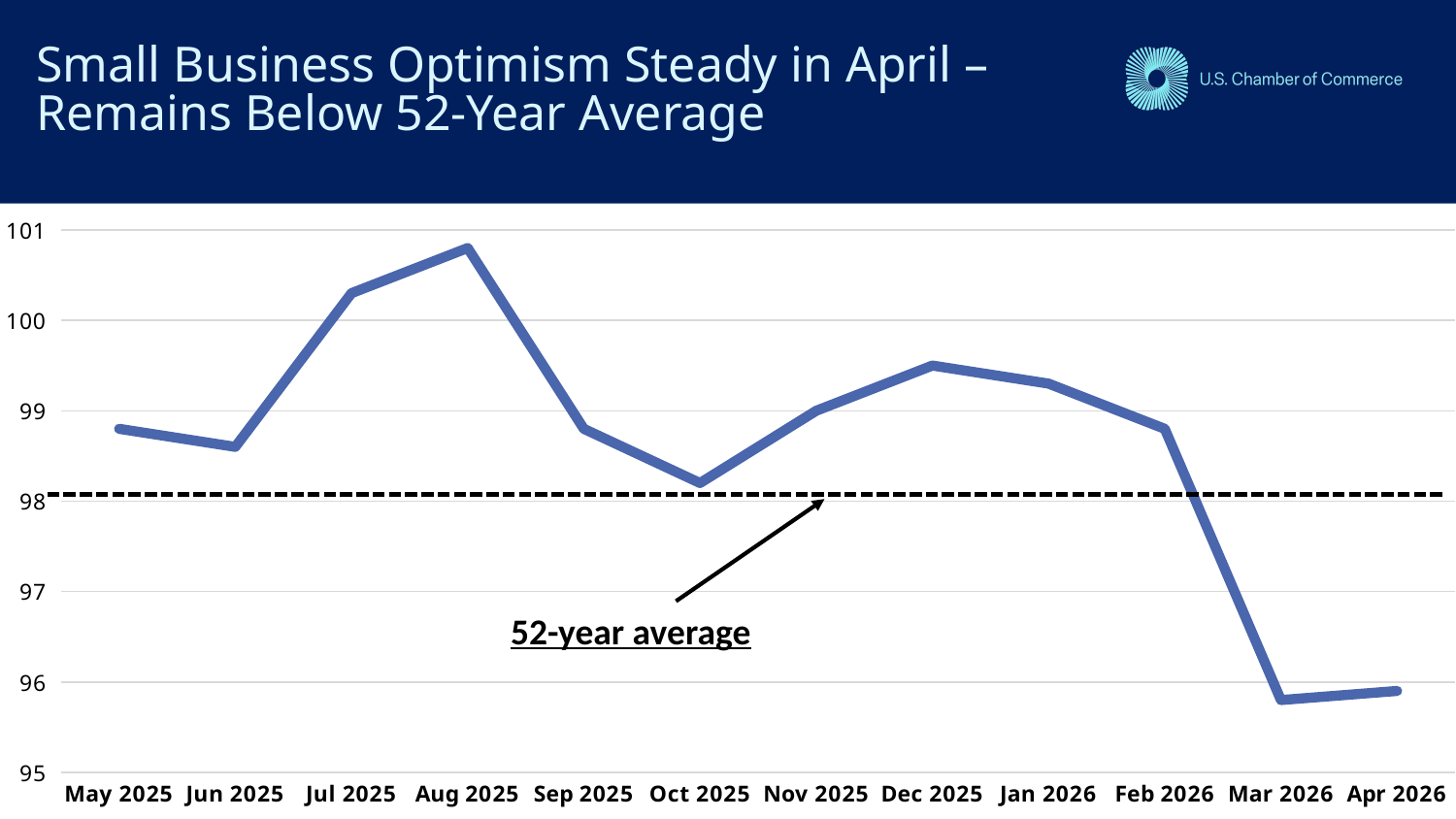
Which month has the lowest value on the chart? Mar 2026 How many months are plotted along the x axis? 12 Which is larger, the value for Aug 2025 or the value for Dec 2025? Aug 2025 Is the value for Dec 2025 greater or less than 99? greater Is the value for Oct 2025 greater or less than 99? less What does the dashed horizontal line on the chart represent? 52-year average Which month has the highest value on the chart? Aug 2025 What kind of chart is shown on the slide? line chart Is the value for Apr 2026 greater or less than 97? less Does the line rise or fall from Feb 2026 to Mar 2026? fall Does the line rise or fall from Oct 2025 to Dec 2025? rise